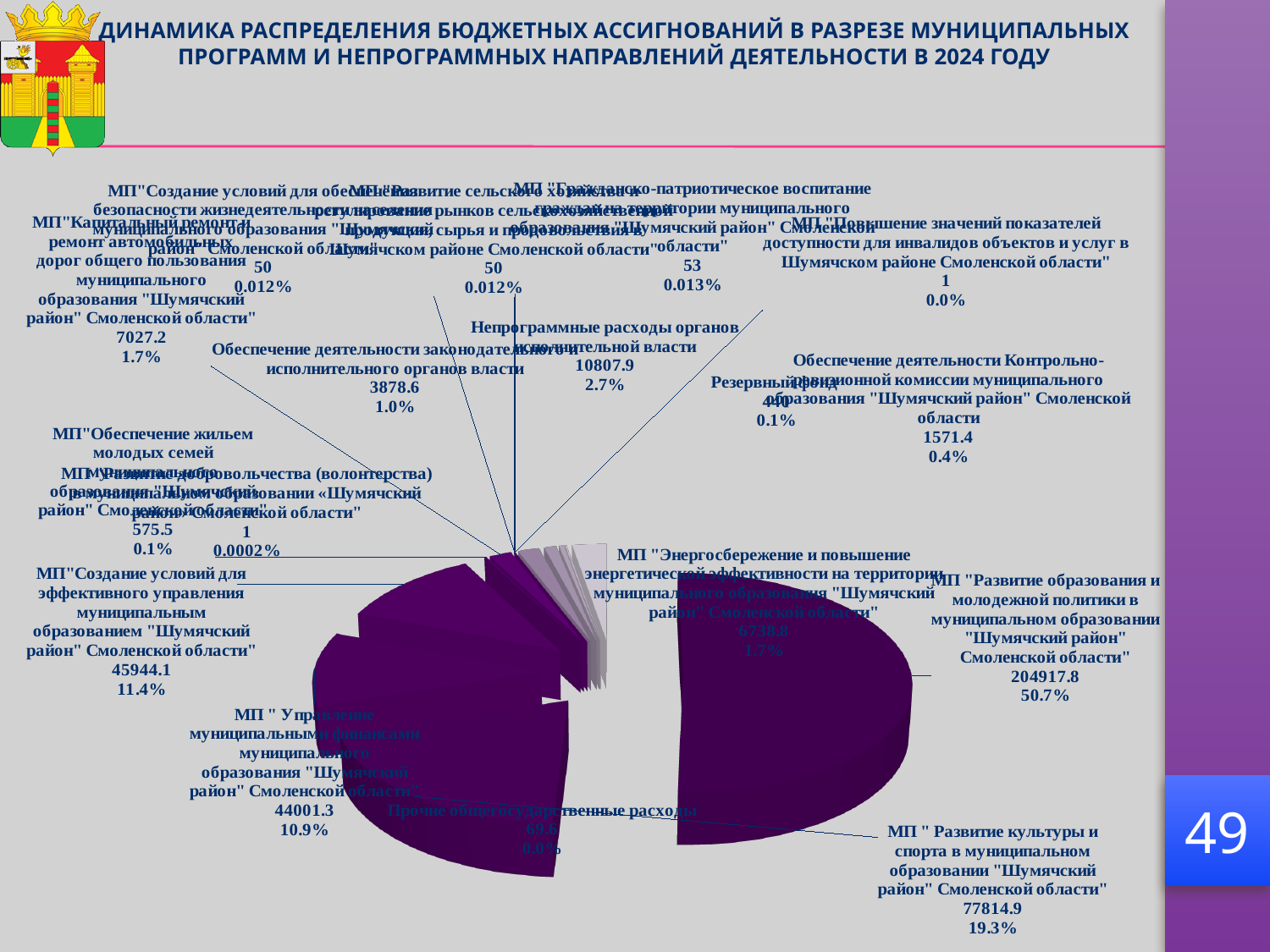
What is the value shown for Непрограммные расходы органов исполнительной власти? 10807.9 What kind of chart is shown on the slide? Pie chart What share of the pie does Обеспечение деятельности Контрольно-ревизионной комиссии represent? 0.4% What is the value shown for МП "Управление муниципальными финансами муниципального образования "Шумячский район" Смоленской области"? 44001.3 What is the title of the chart on the slide? ДИНАМИКА РАСПРЕДЕЛЕНИЯ БЮДЖЕТНЫХ АССИГНОВАНИЙ В РАЗРЕЗЕ МУНИЦИПАЛЬНЫХ ПРОГРАММ И НЕПРОГРАММНЫХ НАПРАВЛЕНИЙ ДЕЯТЕЛЬНОСТИ В 2024 ГОДУ What share of the pie does МП "Развитие образования и молодежной политики" account for? 50.7% What share of the pie does МП "Развитие культуры и спорта" represent? 19.3% Which is larger: the value for МП "Создание условий для эффективного управления" or the value for МП "Управление муниципальными финансами"? МП "Создание условий для эффективного управления" Which category has the largest share of the pie? МП "Развитие образования и молодежной политики в муниципальном образовании "Шумячский район" Смоленской области" What is the value shown for МП "Развитие культуры и спорта в муниципальном образовании "Шумячский район" Смоленской области"? 77814.9 What is the value shown for МП "Создание условий для эффективного управления муниципальным образованием "Шумячский район" Смоленской области"? 45944.1 What is the difference between the values for МП "Развитие образования и молодежной политики" (204917.8) and МП "Развитие культуры и спорта" (77814.9)? 127102.9